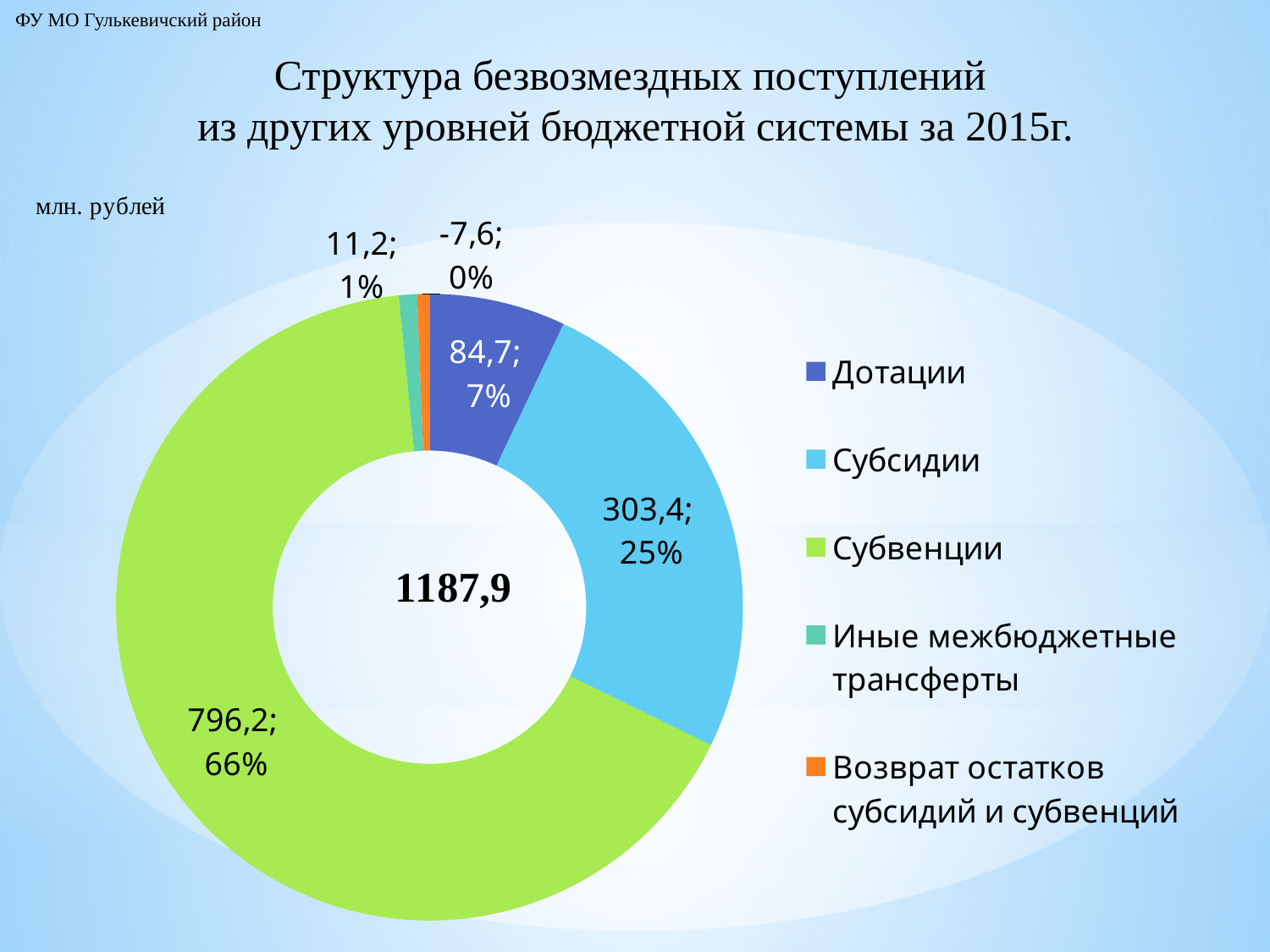
How many categories does the legend list? 5 What is the value for Иные межбюджетные трансферты? 11,2 What is the difference between the values for Субвенции and Субсидии? 492,8 Which category has the largest share of the chart? Субвенции What is the value for Субсидии? 303,4 What is the value for Дотации? 84,7 What is the value for Возврат остатков субсидий и субвенций? -7,6 What share of the total do Субсидии make up? 25% What kind of chart is shown on the slide? Doughnut (pie) chart What is the value for Субвенции? 796,2 Which category has the smallest value? Возврат остатков субсидий и субвенций Which is larger, Дотации or Субсидии? Субсидии